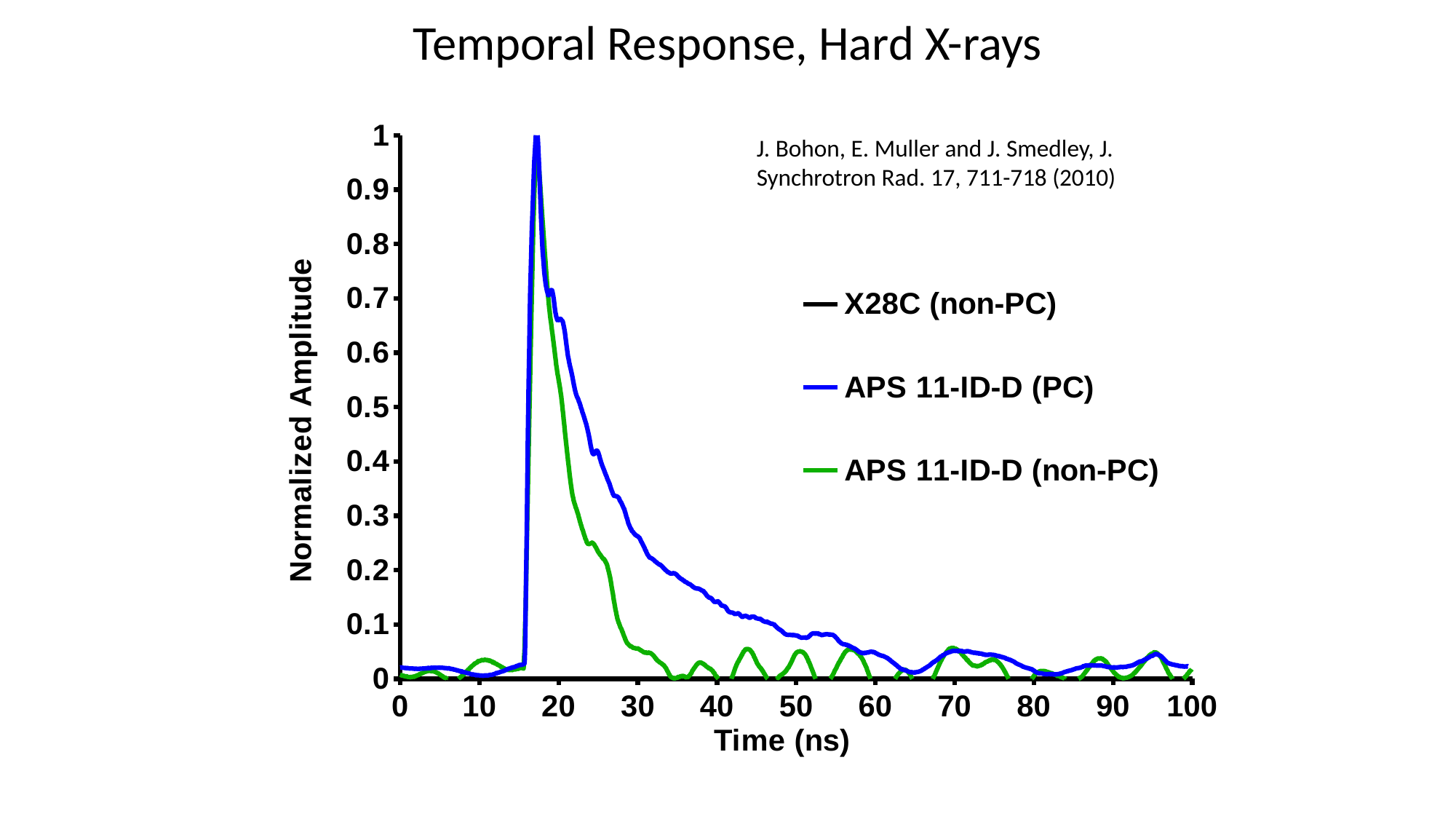
Which series reaches the highest normalized amplitude on the chart? APS 11-ID-D (PC) After its peak near 17 ns, does the APS 11-ID-D (PC) curve rise or fall as time increases? fall What kind of chart is shown on the slide? line chart What colour is the APS 11-ID-D (PC) line? blue How many series does the legend list? 3 What is the maximum normalized amplitude reached by the APS 11-ID-D (PC) curve? 1 Is the value of the APS 11-ID-D (PC) curve at 50 ns greater or less than 0.1? less Is the value of the APS 11-ID-D (non-PC) curve at 30 ns greater or less than 0.1? less At 40 ns, which curve has the higher normalized amplitude, APS 11-ID-D (PC) or APS 11-ID-D (non-PC)? APS 11-ID-D (PC) Is the value of the APS 11-ID-D (PC) curve at 20 ns greater or less than 0.5? greater What is the title of the chart? Temporal Response, Hard X-rays